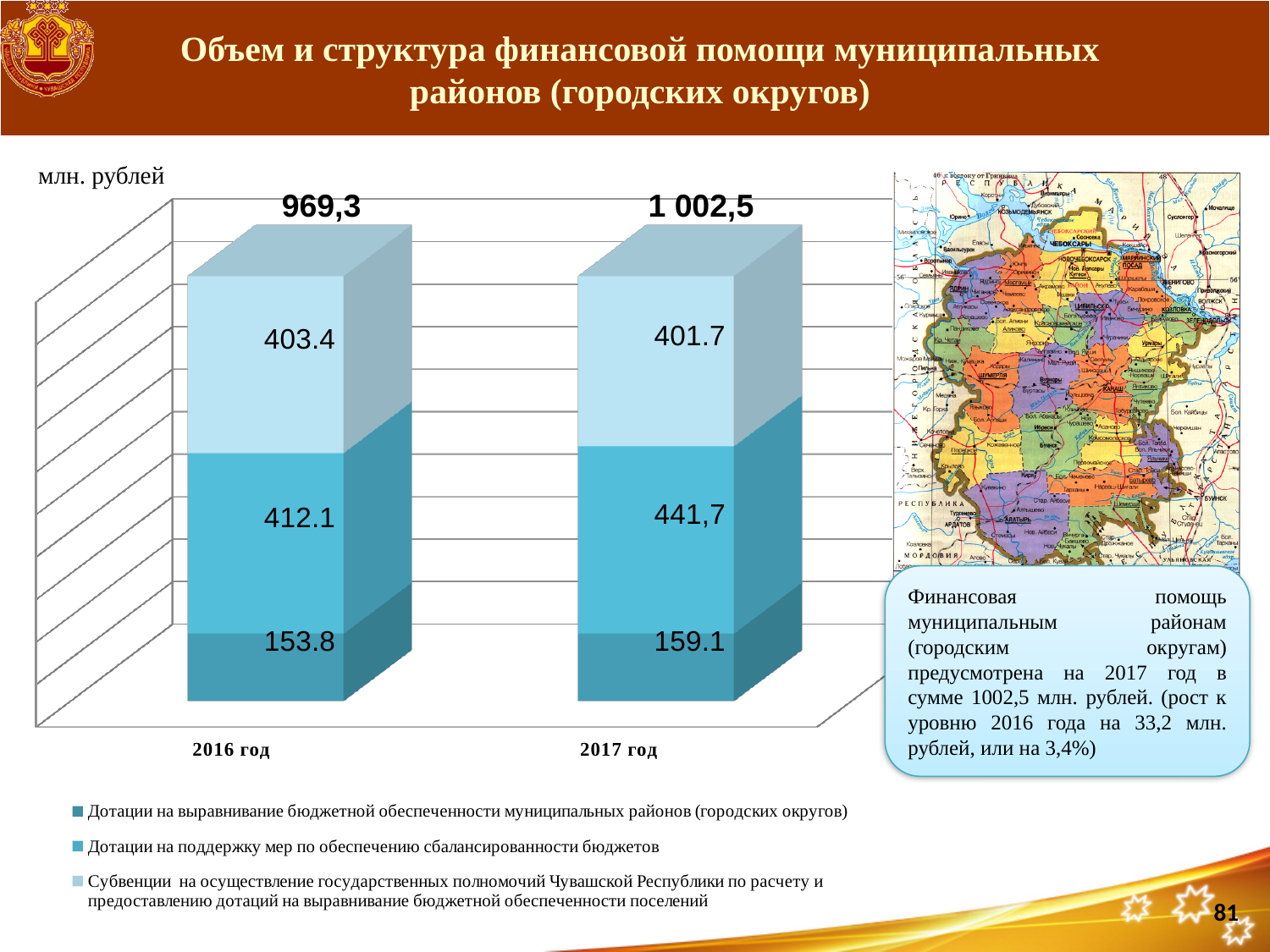
What is the value of the middle segment (Дотации на поддержку мер по обеспечению сбалансированности бюджетов) for 2017 год? 441,7 What is the value of the top segment (Субвенции) for 2017 год? 401.7 By how much does the middle segment (Дотации на поддержку мер по обеспечению сбалансированности бюджетов) in 2017 год exceed that in 2016 год? 29.6 How many series does the chart legend list? 3 What is the value of the top segment (Субвенции) for 2016 год? 403.4 What is the value of the bottom segment (Дотации на выравнивание бюджетной обеспеченности) for 2016 год? 153.8 What is the total value of the bar for 2016 год? 969,3 What unit of measurement is indicated above the chart? млн. рублей Which year has the larger total financial aid, 2016 год or 2017 год? 2017 год What type of chart is shown on the slide? Stacked bar chart How many categories (years) are shown on the x axis of the chart? 2 What is the total value of the bar for 2017 год? 1 002,5